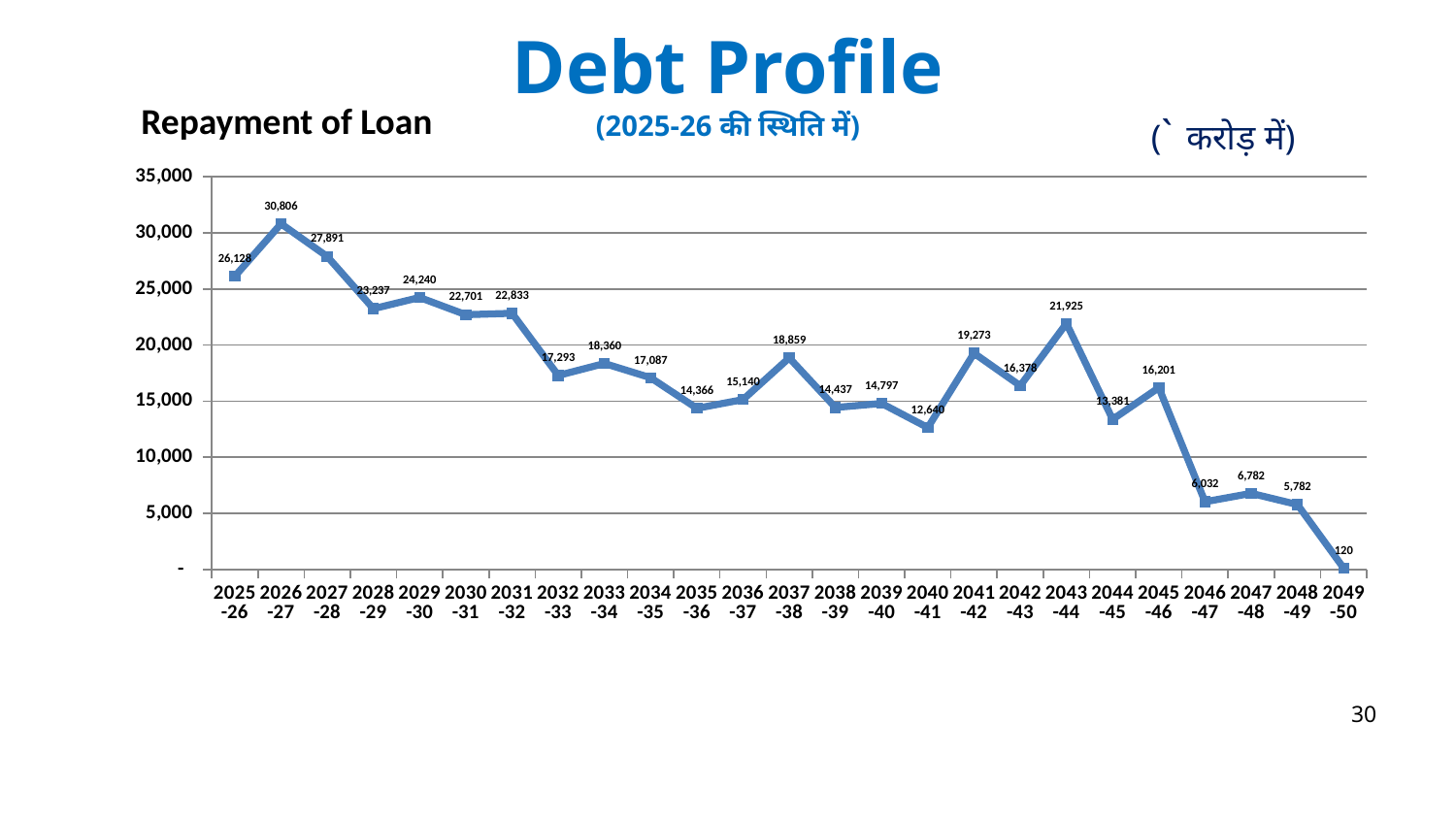
What is the repayment of loan value for 2049-50? 120 Which year has the lowest repayment of loan value? 2049-50 Overall, do the repayment values rise or fall from 2025-26 to 2049-50? Fall What type of chart is shown on the slide? Line chart What is the difference between the repayment values for 2026-27 and 2027-28? 2,915 What is the repayment of loan value for 2026-27? 30,806 Which year has the highest repayment of loan value? 2026-27 What is the title of the chart on the slide? Repayment of Loan How many years (data points) are plotted on the chart? 25 What is the repayment of loan value for 2043-44? 21,925 Which is larger, the repayment value for 2037-38 or for 2041-42? 2041-42 Is the repayment value for 2040-41 greater or less than 15,000? less